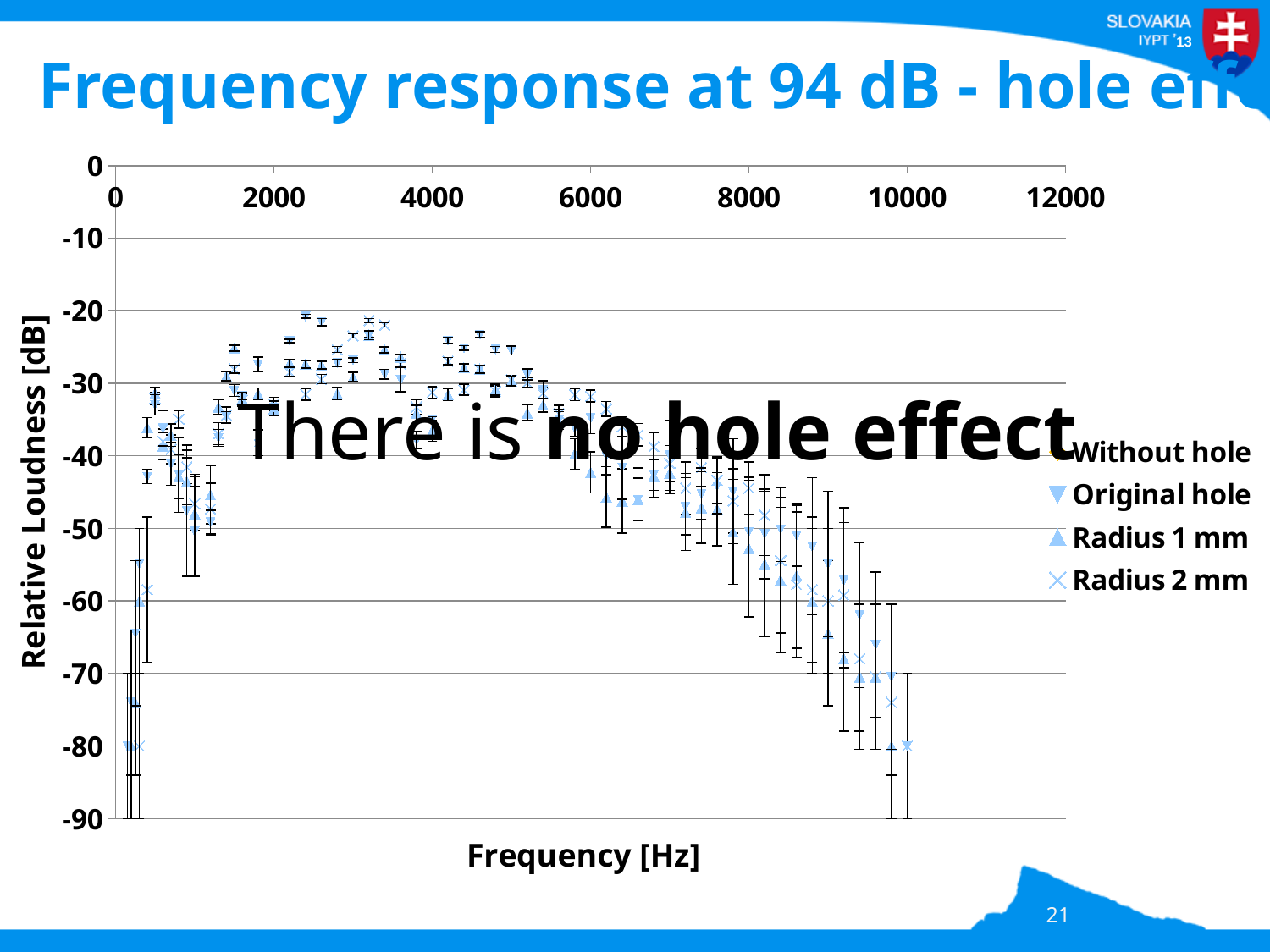
Are the plotted values near 2000 Hz greater or less than -50 dB? greater Which series in the legend is marked with an X-shaped marker? Radius 2 mm Are the plotted values near 10000 Hz greater or less than -50 dB? less What kind of chart is shown on the slide? scatter chart How many series does the chart legend list? 4 Are the plotted values near 3000 Hz greater or less than -40 dB? greater What is the label of the y axis of the chart? Relative Loudness [dB] Which series is listed first in the chart legend? Without hole What is the label of the x axis of the chart? Frequency [Hz] Do the plotted values rise or fall as frequency increases from 6000 Hz to 10000 Hz? fall What is the lowest value shown on the y axis of the chart? -90